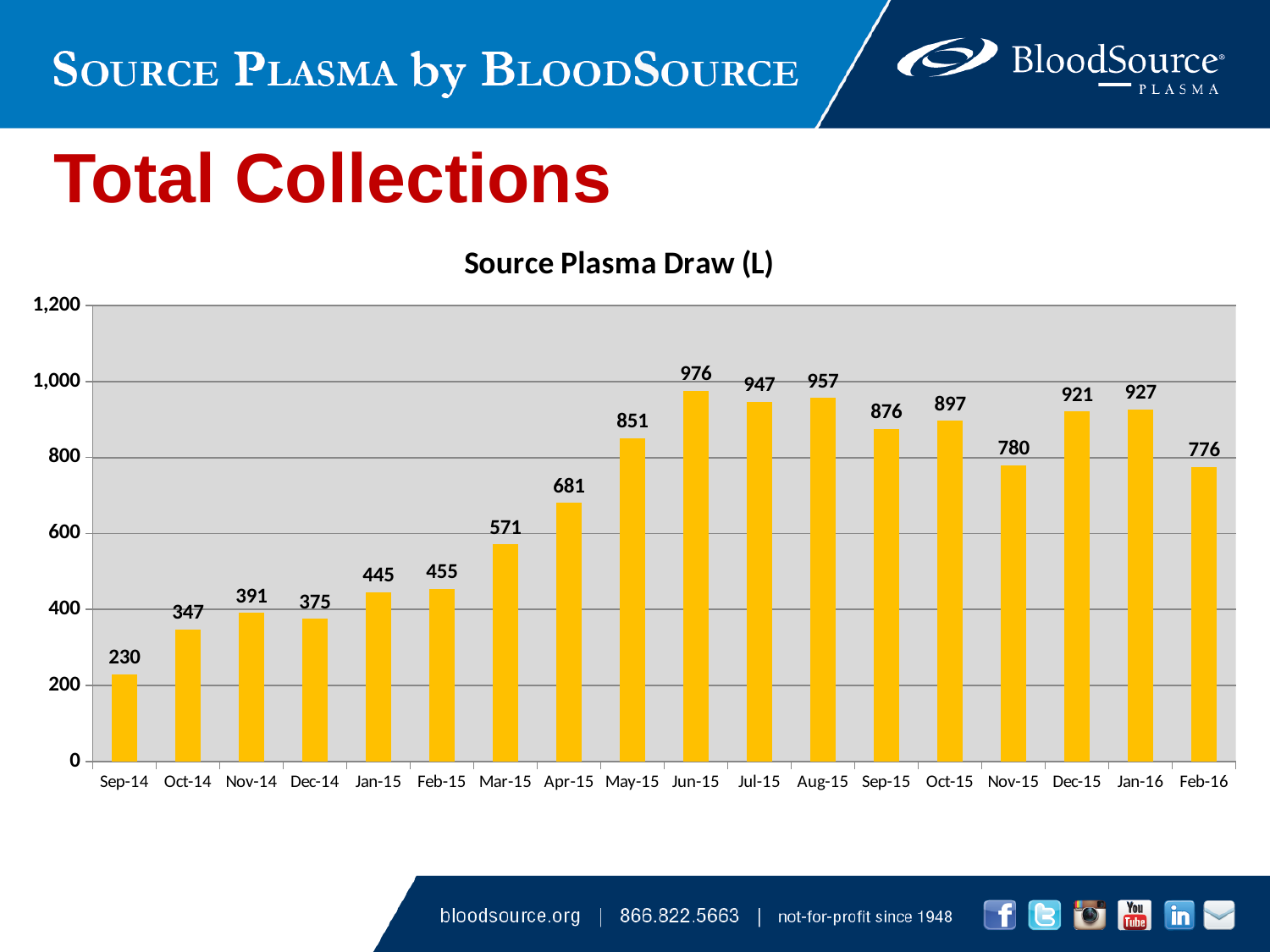
Which month has the lowest value? Sep-14 How many months are shown on the x axis? 18 What is the title of the chart? Source Plasma Draw (L) What is the value for Sep-14? 230 What is the value for Jun-15? 976 Is the value for Mar-15 greater or less than 600? less Which is larger, the value for Aug-15 or the value for Jul-15? Aug-15 What is the difference between the values for Jun-15 and Sep-14? 746 What is the difference between the values for Jan-16 and Feb-16? 151 What kind of chart is this? bar chart Which month has the highest value? Jun-15 What is the value for Nov-15? 780